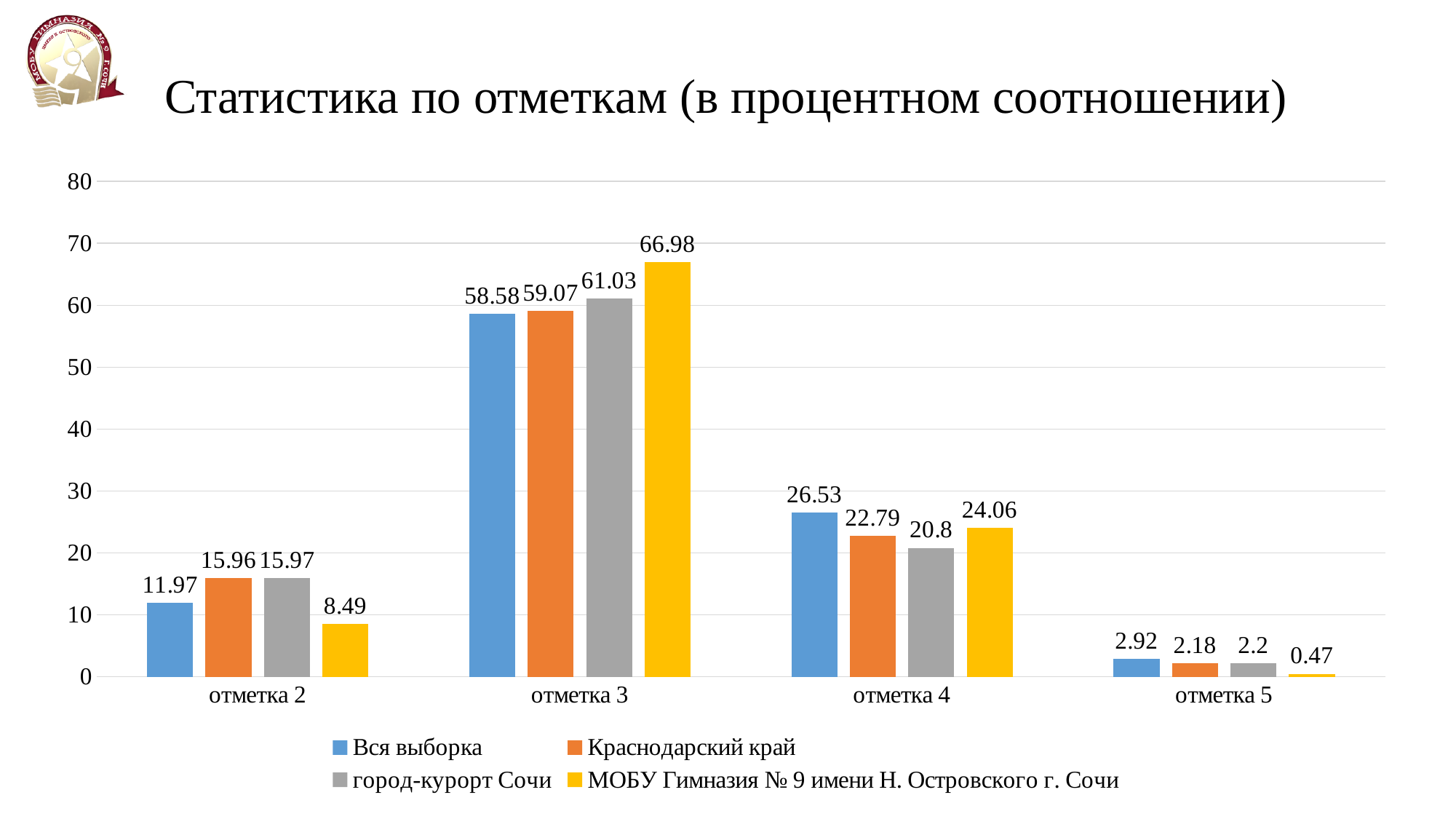
What is the value for Краснодарский край at отметка 2? 15.96 What is the value for Вся выборка at отметка 4? 26.53 What is the value for город-курорт Сочи at отметка 5? 2.2 Which is larger at отметка 4: Краснодарский край or МОБУ Гимназия № 9 имени Н. Островского г. Сочи? МОБУ Гимназия № 9 имени Н. Островского г. Сочи Which series has the lowest value at отметка 5? МОБУ Гимназия № 9 имени Н. Островского г. Сочи Is the value for город-курорт Сочи at отметка 3 greater or less than 60? greater How many categories are shown on the x axis? 4 What kind of chart is shown on the slide? bar chart How many series does the legend list? 4 Which series has the highest value at отметка 3? МОБУ Гимназия № 9 имени Н. Островского г. Сочи What is the difference between the МОБУ Гимназия № 9 value and the Вся выборка value at отметка 3? 8.4 What is the value for МОБУ Гимназия № 9 имени Н. Островского г. Сочи at отметка 3? 66.98